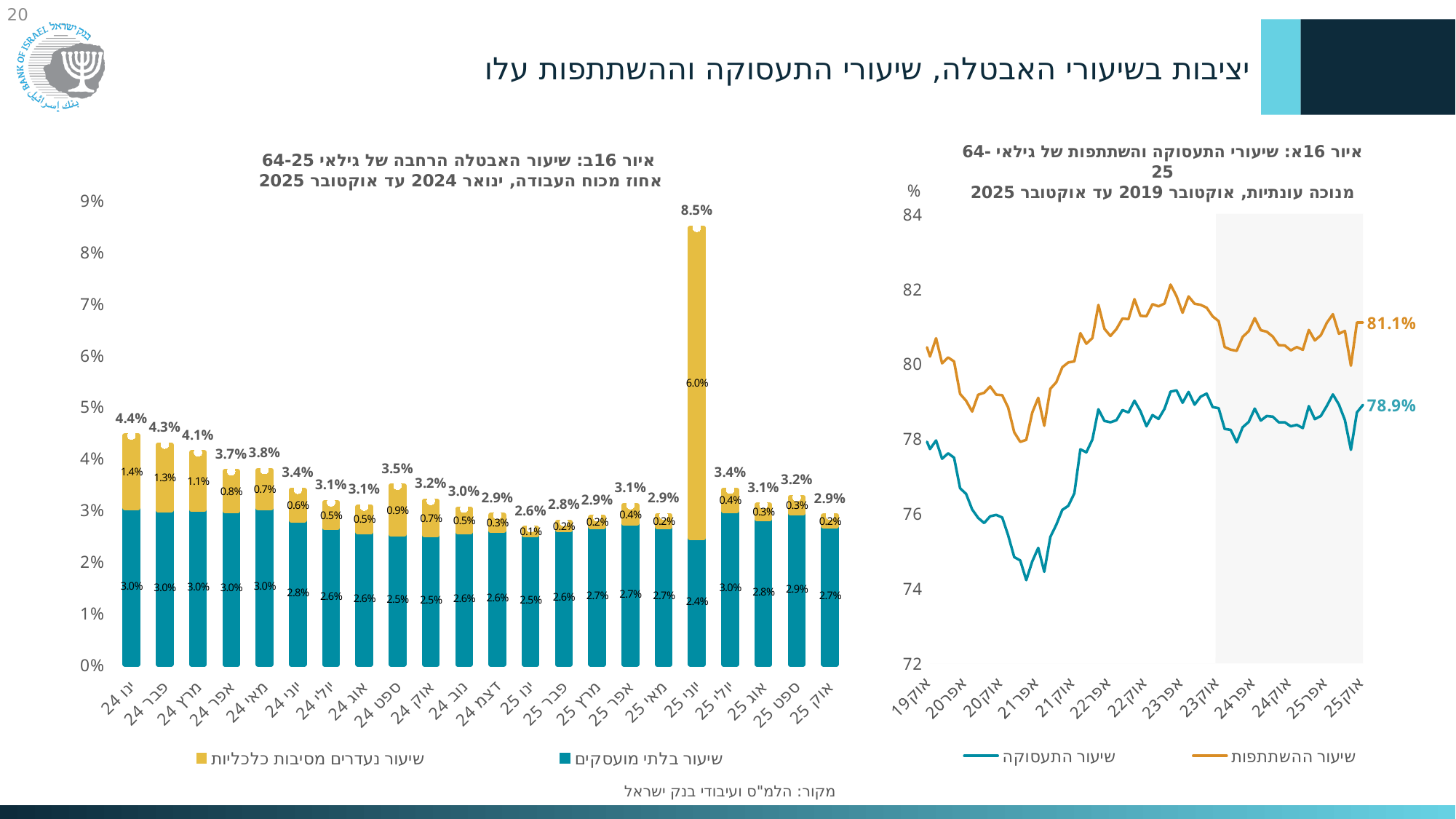
What type of chart is the left chart (איור 16ב)? Stacked bar chart In the left chart (איור 16ב), what is the value of the שיעור נעדרים מסיבות כלכליות segment for יוני 25? 6.0% In the left chart (איור 16ב), what is the difference between the total for ינו 24 and the total for אוק 25? 1.5% In the left chart (איור 16ב), which month has the lowest total broad unemployment rate? ינו 25 In the left chart (איור 16ב), which is larger: the total for ספט 24 or the total for אוק 24? ספט 24 In the right chart (איור 16א), is the value of the שיעור התעסוקה line at אפר 21 greater or less than 76? less In the left chart (איור 16ב), which month has the highest total broad unemployment rate? יוני 25 In the left chart (איור 16ב), how many monthly bars are plotted? 22 In the right chart (איור 16א), how many series does the legend list? 2 In the left chart (איור 16ב), what is the total broad unemployment rate for יוני 25? 8.5% In the right chart (איור 16א), what is the final labelled value of the שיעור ההשתתפות line? 81.1% In the left chart (איור 16ב), what is the value of the שיעור בלתי מועסקים segment for ינו 24? 3.0%